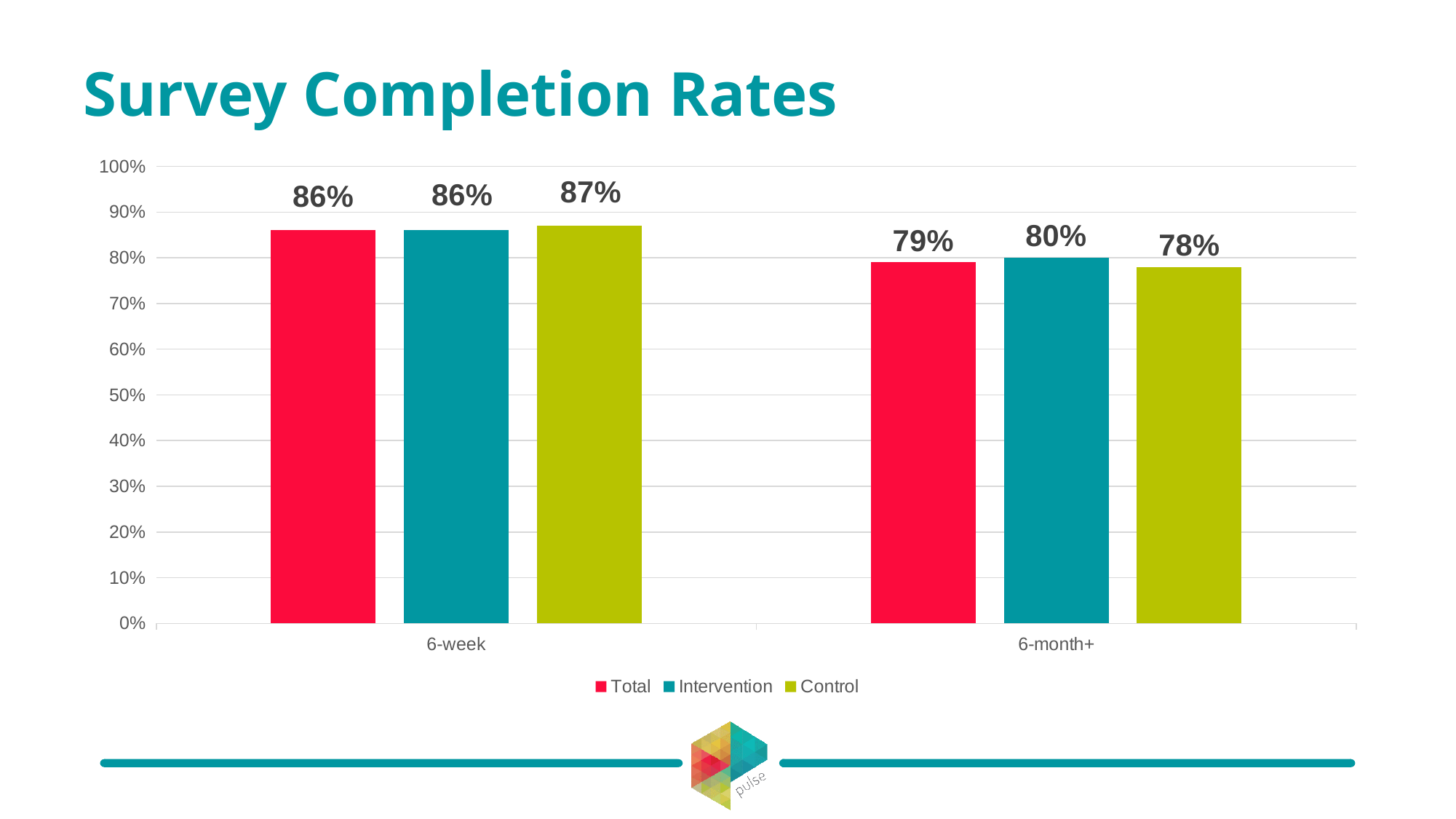
Do the completion rates rise or fall from 6-week to 6-month+? fall What is the Control group's completion rate at 6-month+? 78% Is the Control completion rate at 6-month+ greater or less than 80%? less What is the difference between the Intervention and Control completion rates at 6-month+? 2% What is the difference between the Total completion rate at 6-week and at 6-month+? 7% How many time-point categories are shown on the x axis? 2 What is the survey completion rate for the Control group at 6-week? 87% What is the title of the chart? Survey Completion Rates What is the Total survey completion rate at 6-week? 86% What kind of chart is shown on the slide? bar chart How many series does the legend list? 3 What is the survey completion rate for the Intervention group at 6-month+? 80%